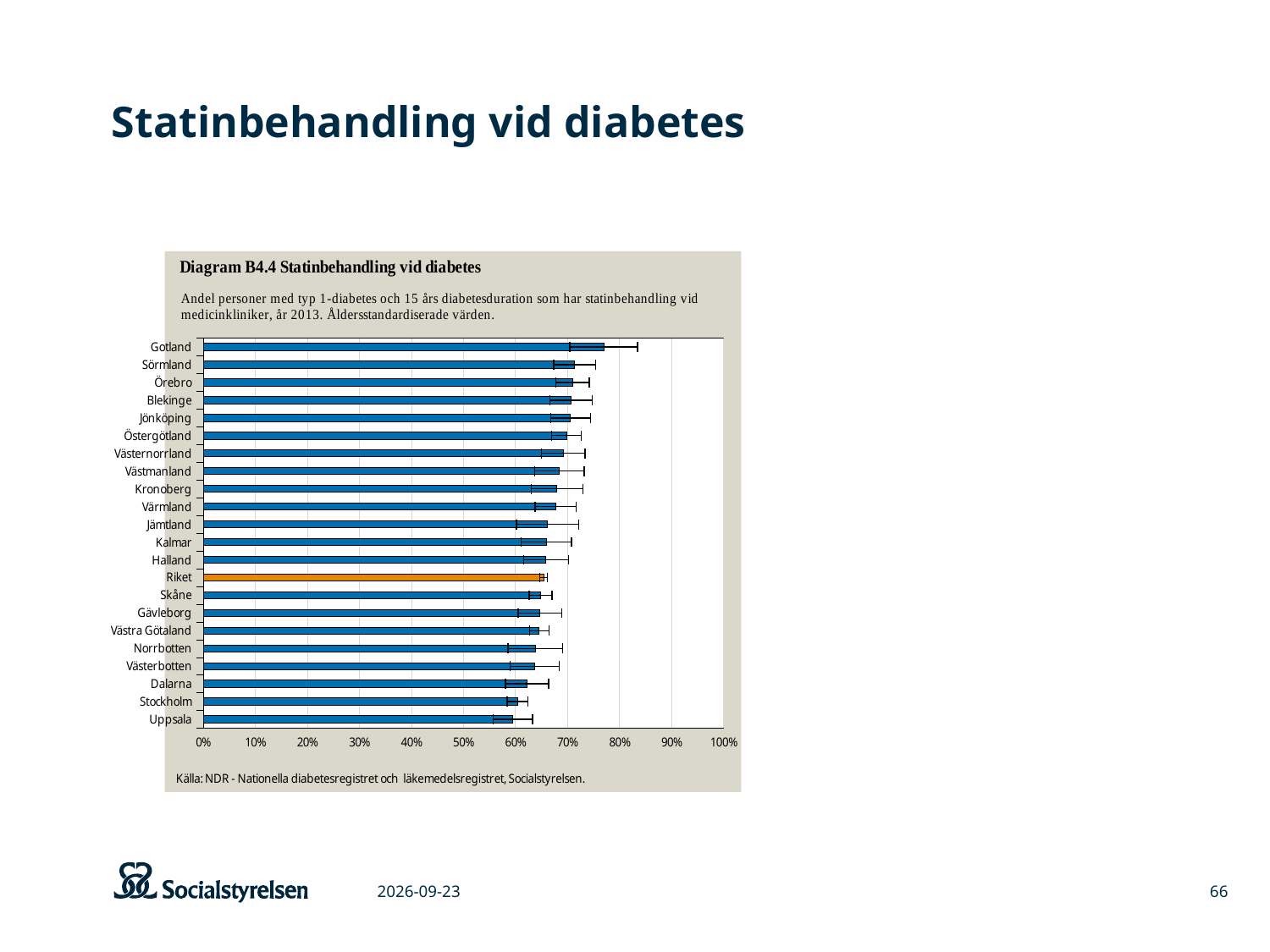
Which category is shown with an orange bar instead of a blue one? Riket Which has a larger value, Gotland or Uppsala? Gotland Is the value for Gotland greater or less than 70%? greater What kind of chart is shown on the slide? bar chart How many categories (regions including Riket) are plotted in the chart? 22 Which has a larger value, Sörmland or Stockholm? Sörmland Which category has the lowest value in the chart? Uppsala Is the value for Riket greater or less than 70%? less Do the bar values rise or fall going from the top category to the bottom category? fall Which category has the highest value in the chart? Gotland Is the value for Stockholm greater or less than 70%? less